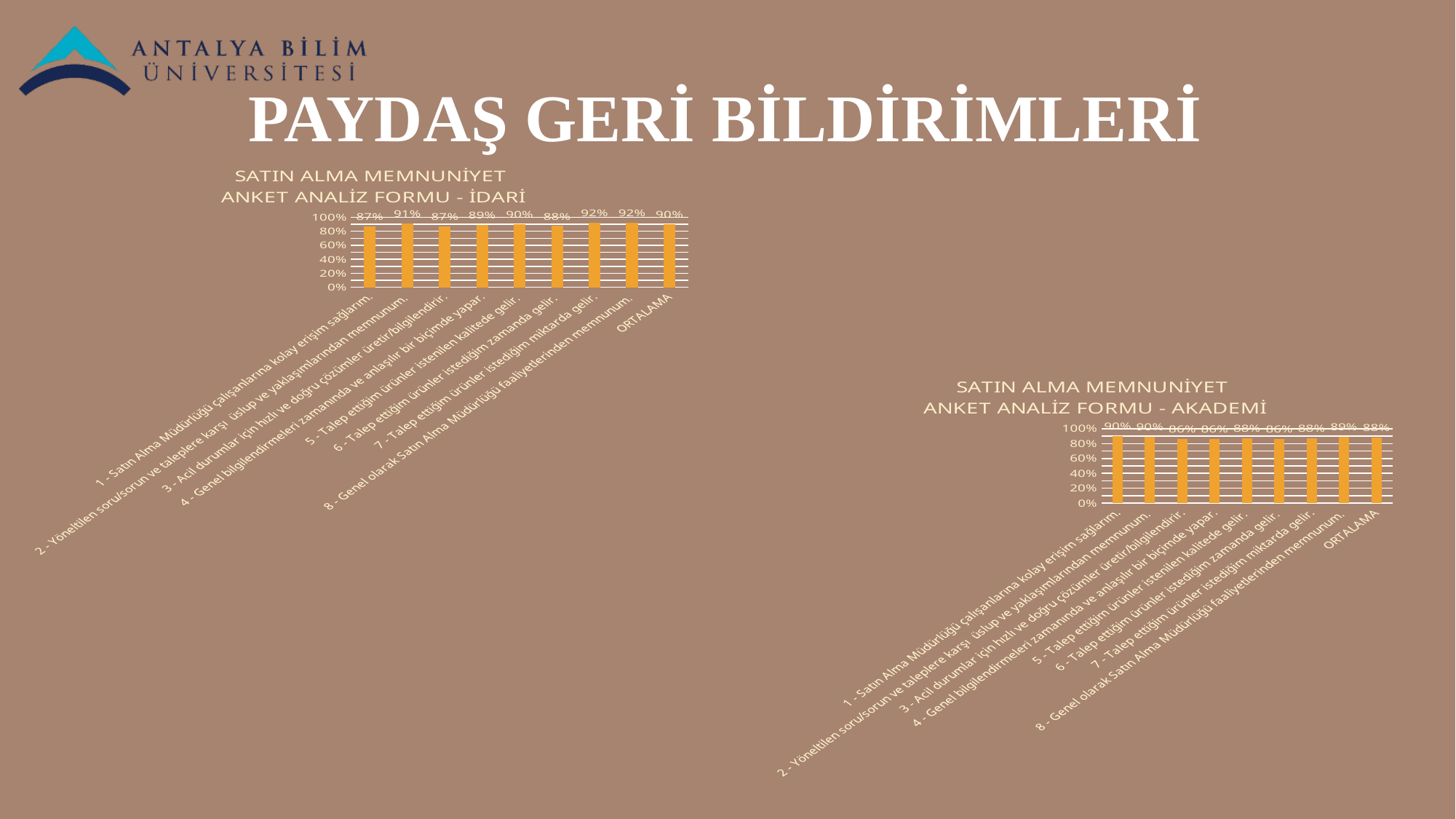
Which is larger: the ORTALAMA value in the İDARİ chart or the ORTALAMA value in the AKADEMİ chart? İDARİ How many bars are shown in the İDARİ chart? 9 In the AKADEMİ chart, what is the value for item 1 (Satın Alma Müdürlüğü çalışanlarına kolay erişim sağlarım)? 90% In the AKADEMİ chart, what is the difference between the value for item 1 and the value for item 3? 4% What type of chart is the AKADEMİ chart? Bar chart In the İDARİ chart, what is the value for item 7 (Talep ettiğim ürünler istediğim miktarda gelir)? 92% In the İDARİ chart, what is the value for ORTALAMA? 90% In the İDARİ chart, what is the difference between the value for item 7 and the value for item 1? 5% In the İDARİ chart, what is the value for item 2 (Yöneltilen soru/sorun ve taleplere karşı üslup ve yaklaşımlarından memnunum)? 91% In the AKADEMİ chart, what is the value for item 8 (Genel olarak Satın Alma Müdürlüğü faaliyetlerinden memnunum)? 89% In the AKADEMİ chart, what is the value for ORTALAMA? 88% What is the title of the chart on the right side of the slide? SATIN ALMA MEMNUNİYET ANKET ANALİZ FORMU - AKADEMİ